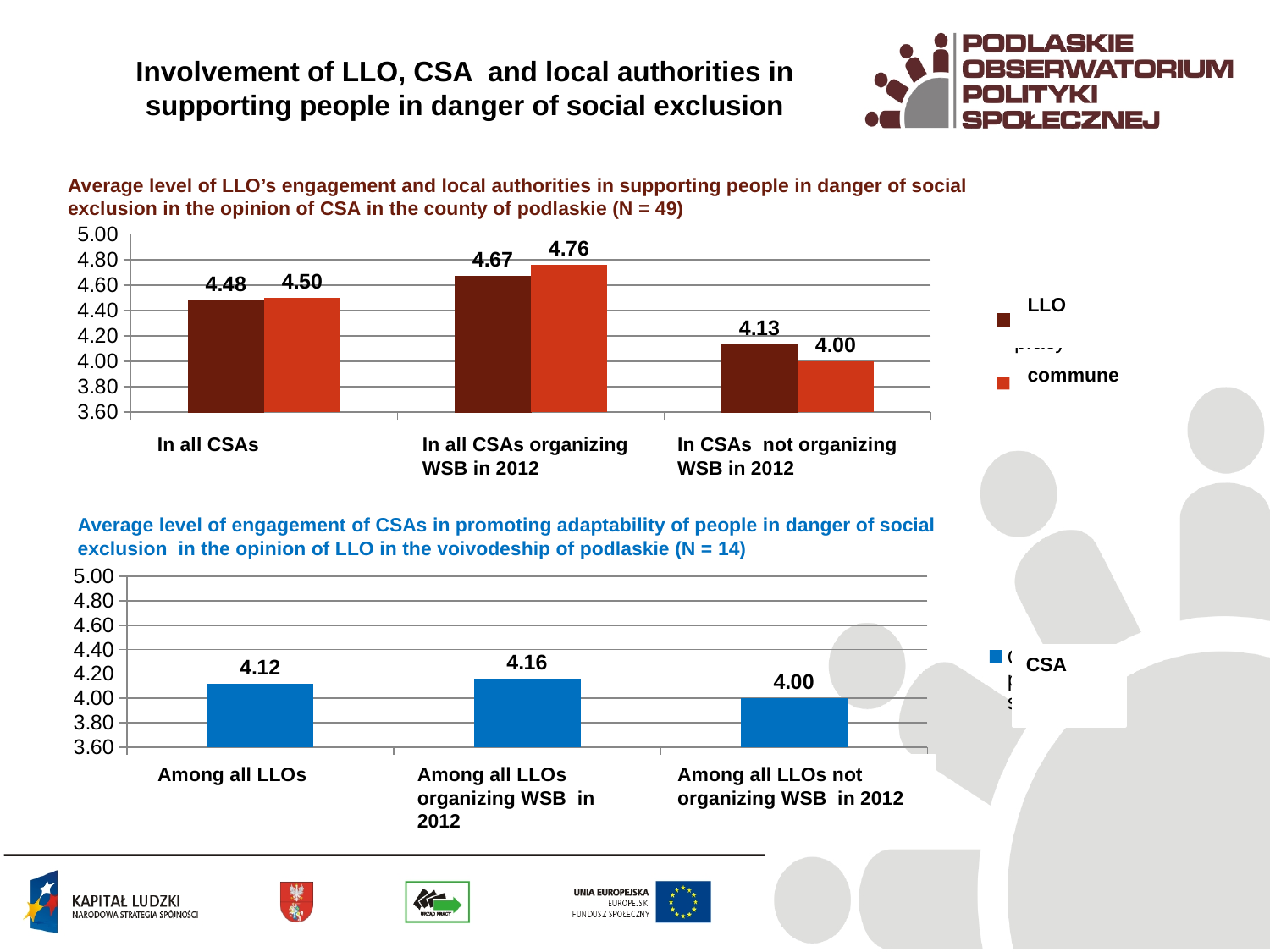
In the top chart, what is the difference between the commune and LLO values for 'In all CSAs organizing WSB in 2012'? 0.09 How many series does the legend of the top chart list? 2 In the bottom chart, what is the difference between 'Among all LLOs' and 'Among all LLOs not organizing WSB in 2012'? 0.12 In the top chart, what is the commune value for 'In CSAs not organizing WSB in 2012'? 4.00 In the top chart, for 'In CSAs not organizing WSB in 2012', which is larger: the LLO value or the commune value? LLO In the top chart, what is the LLO value for 'In all CSAs organizing WSB in 2012'? 4.67 In the bottom chart, which category has the lowest value? Among all LLOs not organizing WSB in 2012 In the top chart, which category has the lowest LLO value? In CSAs not organizing WSB in 2012 How many categories are shown on the x axis of the bottom chart? 3 In the top chart, which category has the highest commune value? In all CSAs organizing WSB in 2012 What type of chart is the bottom chart? Bar chart In the bottom chart, what is the value for 'Among all LLOs organizing WSB in 2012'? 4.16